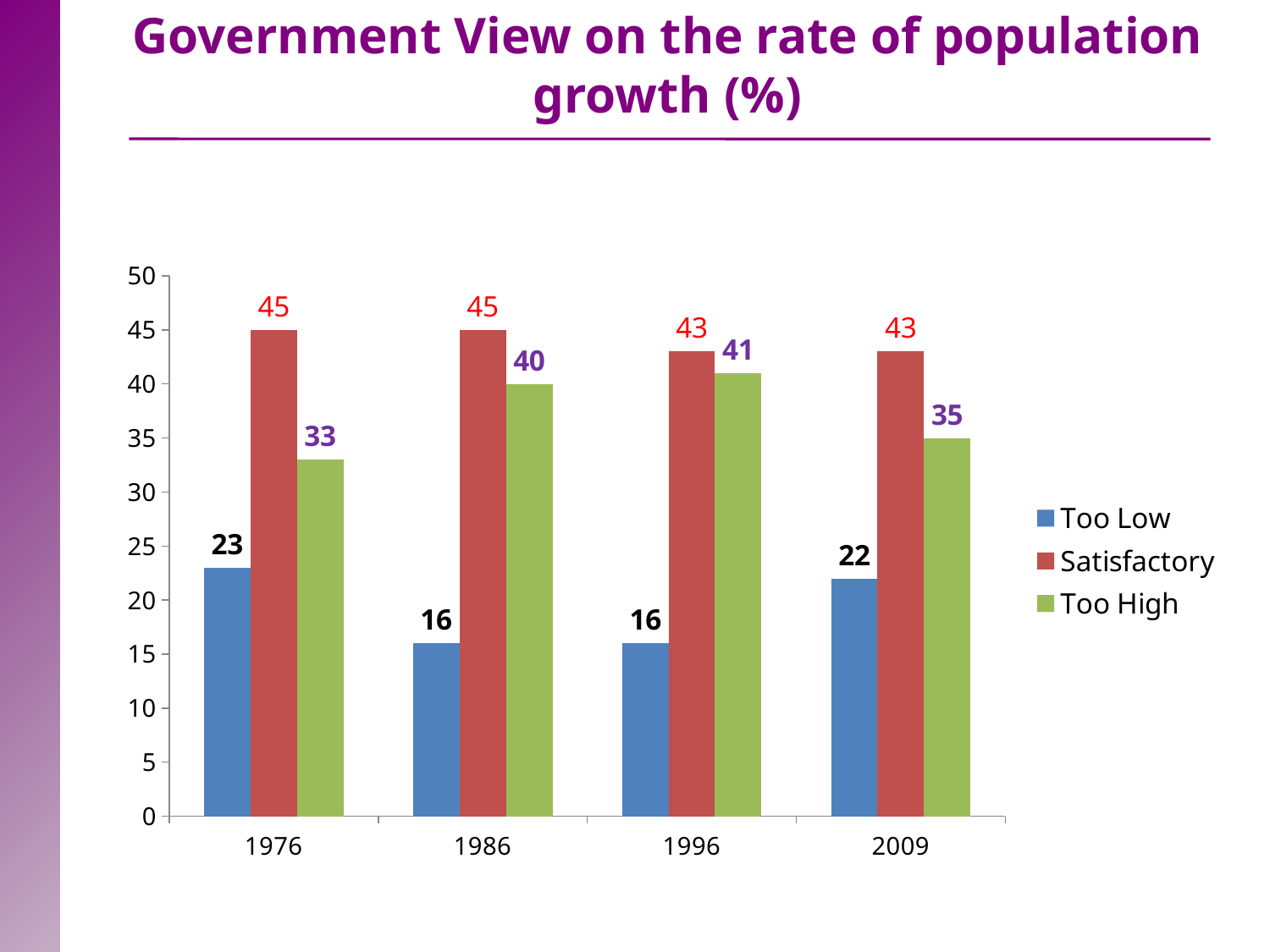
What is the value for Too High in 2009? 35 Does the Too High value rise or fall from 1976 to 1996? Rise In which year is the Too High value highest? 1996 How many series does the legend list? 3 Which is larger in 2009: Satisfactory or Too High? Satisfactory What is the difference between the Satisfactory and Too High values in 1976? 12 What is the title of the chart? Government View on the rate of population growth (%) What kind of chart is shown on the slide? Bar chart How many years are shown on the x axis? 4 What is the value for Too Low in 1976? 23 What is the value for Satisfactory in 1996? 43 In which year is the Too Low value lowest? 1986 and 1996